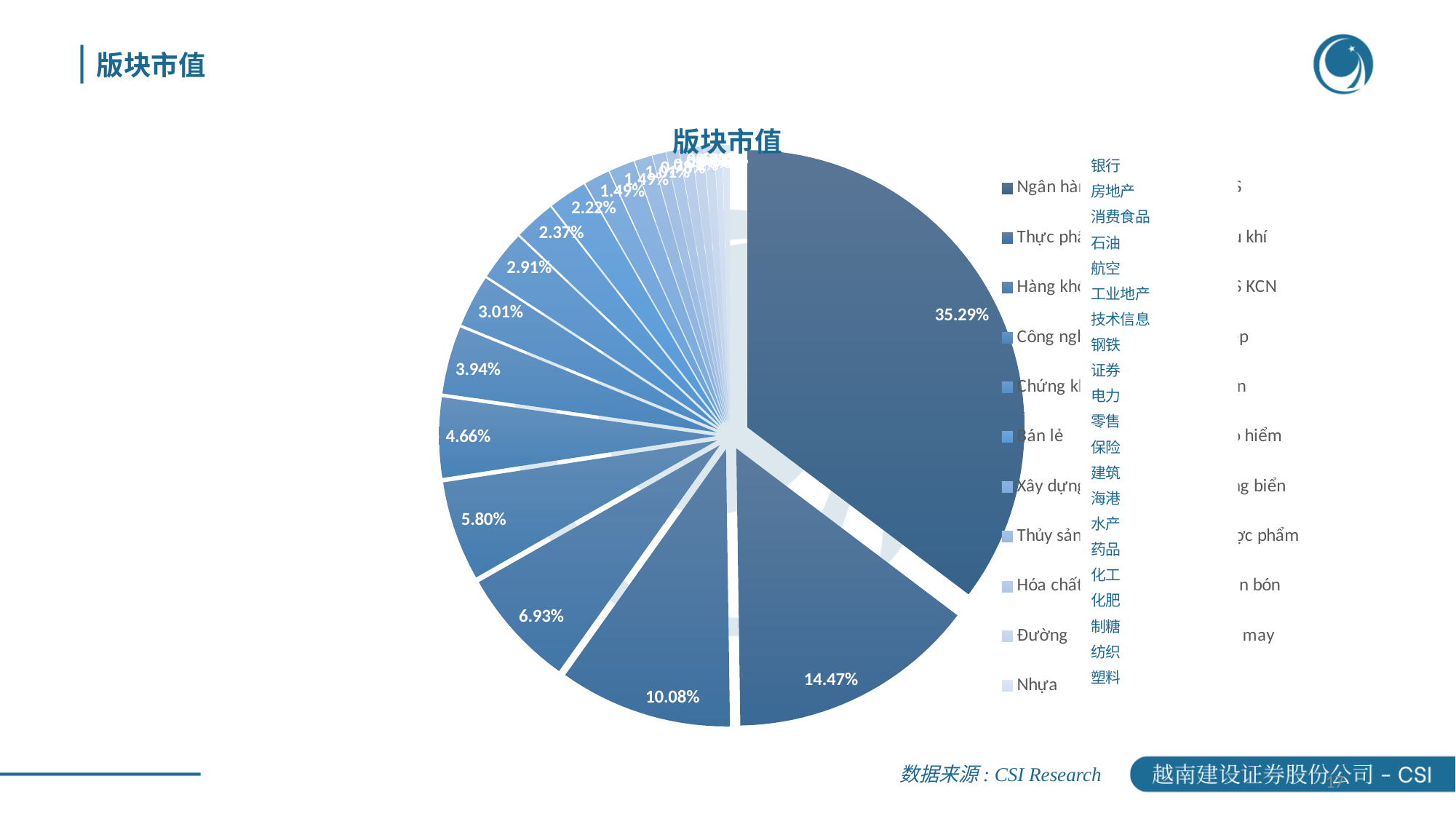
What kind of chart is shown on the slide? pie chart What is the difference in percentage points between the largest slice (35.29%) and the second-largest slice (14.47%)? 20.82% What is the difference between the slices labelled 14.47% and 10.08%? 4.39% What is the share of the third-largest slice in the pie chart? 10.08% What is the share of the second-largest slice in the pie chart? 14.47% Which is larger, the slice labelled 6.93% or the slice labelled 5.80%? 6.93% What is the share of the largest slice in the pie chart? 35.29% What data source is cited below the chart? CSI Research How many sectors are listed in the chart legend? 21 What is the combined share of the two largest slices, 35.29% and 14.47%? 49.76% Which sector (first legend entry) corresponds to the largest slice of 35.29%? 银行 (Ngân hàng) What is the title of the chart? 版块市值